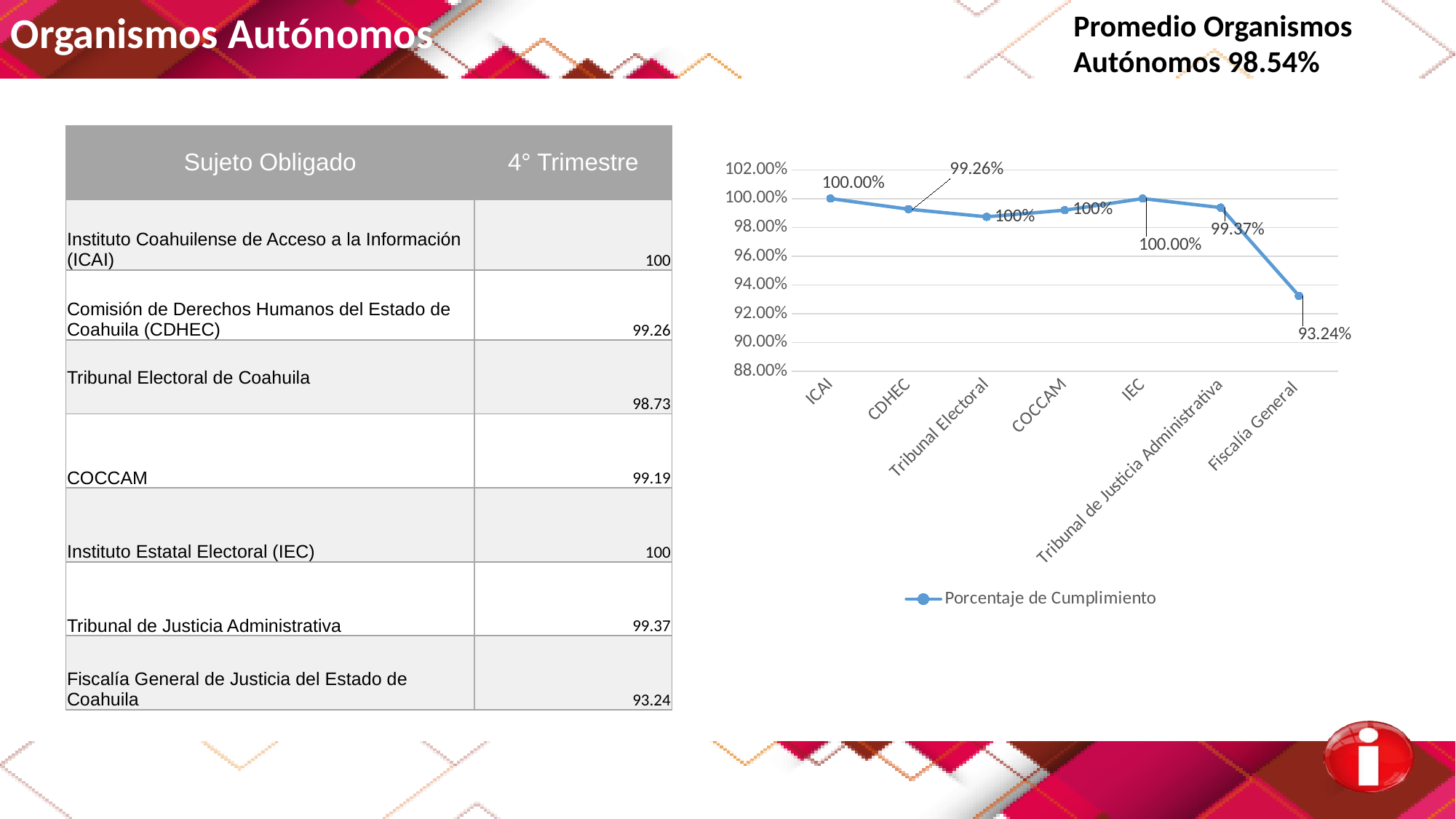
Is the value for Fiscalía General greater or less than 94.00%? less Which is larger, the value for CDHEC or the value for Fiscalía General? CDHEC What is the name of the series shown in the chart legend? Porcentaje de Cumplimiento What is the value plotted for ICAI? 100.00% What is the difference between the values for CDHEC and Fiscalía General? 6.02 percentage points How many series does the chart legend list? 1 What is the value plotted for Tribunal de Justicia Administrativa? 99.37% How many categories are plotted along the x axis of the chart? 7 What is the value plotted for CDHEC? 99.26% What kind of chart is shown on the slide? line chart Which category has the lowest value in the chart? Fiscalía General What is the value plotted for Fiscalía General? 93.24%